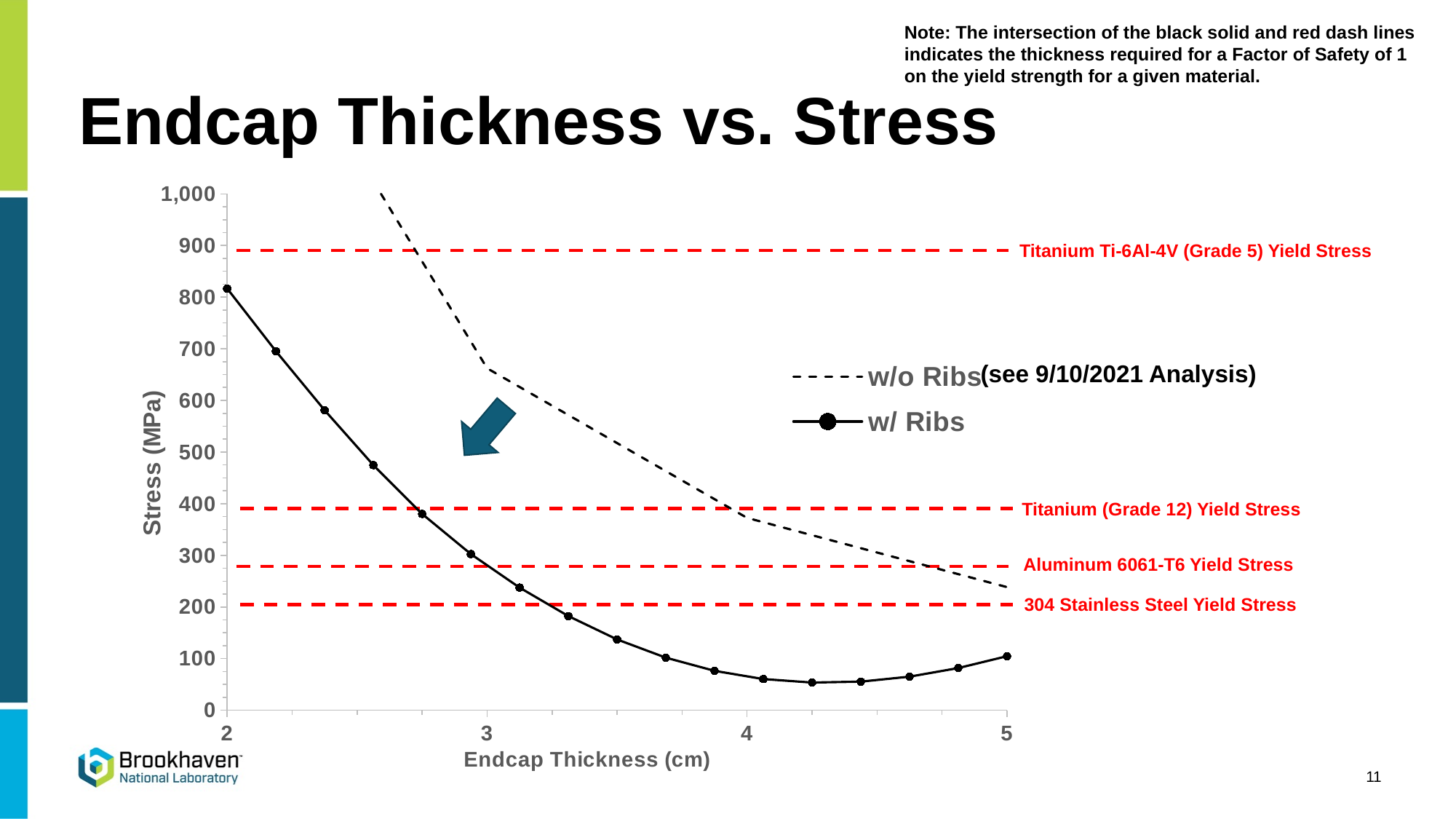
At an endcap thickness of 3 cm, which series shows the higher stress, w/o Ribs or w/ Ribs? w/o Ribs Which material's yield stress reference line is the highest on the chart? Titanium Ti-6Al-4V (Grade 5) What kind of chart is shown on the slide? Line chart Does the stress for the w/o Ribs series rise or fall as endcap thickness increases from 3 cm to 5 cm? fall What is the label of the x axis? Endcap Thickness (cm) Is the stress for the w/o Ribs series at an endcap thickness of 5 cm greater or less than 200 MPa? greater Which material's yield stress reference line is the lowest on the chart? 304 Stainless Steel Is the stress for the w/ Ribs series at an endcap thickness of 5 cm greater or less than 200 MPa? less Is the stress for the w/o Ribs series at an endcap thickness of 4 cm greater or less than 500 MPa? less What is the label of the y axis? Stress (MPa) How many series does the chart legend list? 2